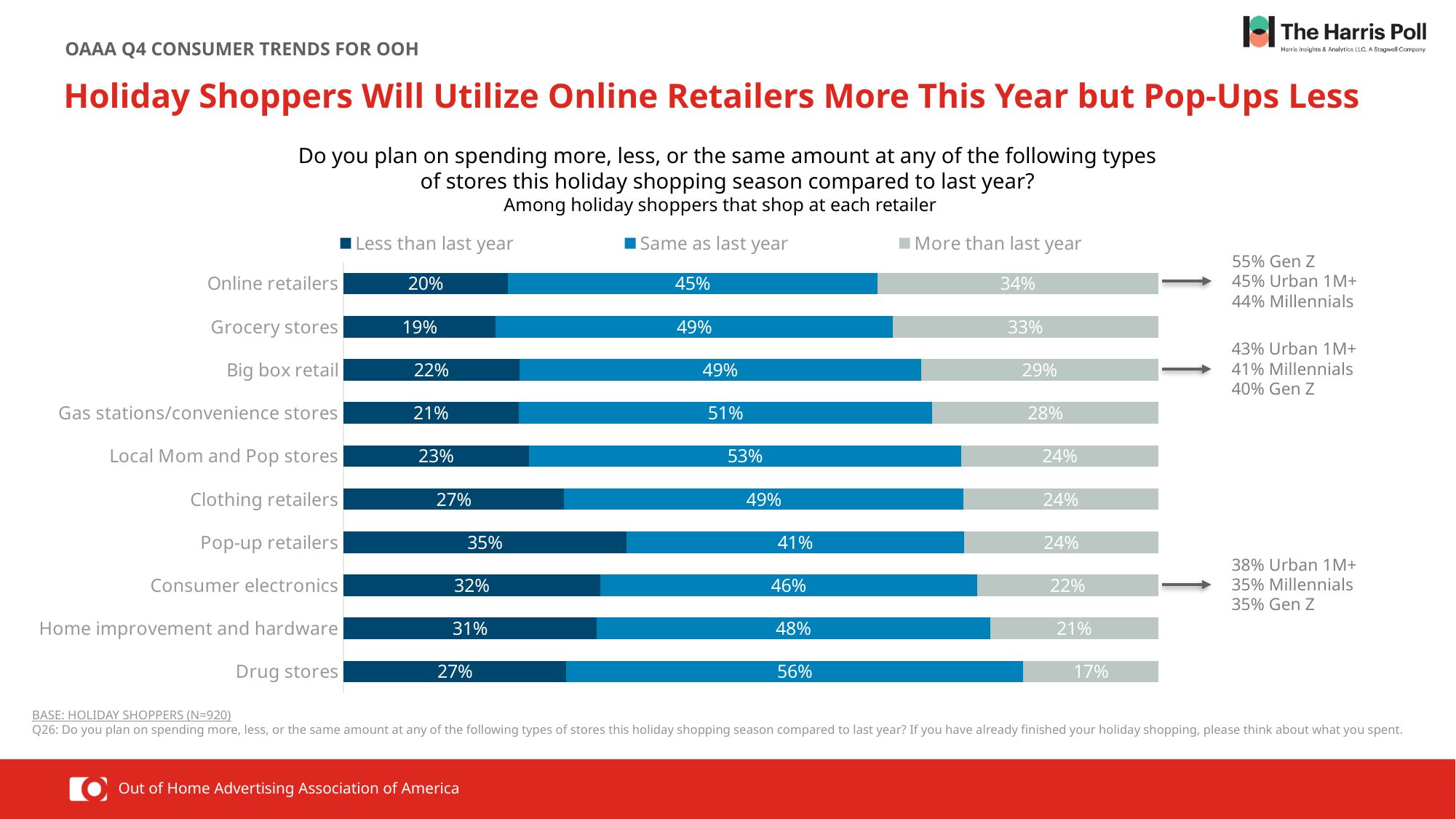
Which store type has the highest share of shoppers planning to spend more than last year? Online retailers What is the difference between the 'More than last year' percentages for online retailers and drug stores? 17% Which store type has the highest share of shoppers planning to spend less than last year? Pop-up retailers How many series does the legend list? 3 How many store types are shown in the chart? 10 What percentage of holiday shoppers plan to spend less than last year at pop-up retailers? 35% Which is larger: the 'Less than last year' share for consumer electronics or for home improvement and hardware? Consumer electronics Which store type has the lowest share of shoppers planning to spend more than last year? Drug stores What is the total of the three segments for the Grocery stores bar? 101% What percentage of holiday shoppers plan to spend more than last year at online retailers? 34% What kind of chart is shown on the slide? Stacked bar chart What percentage of holiday shoppers plan to spend the same as last year at drug stores? 56%